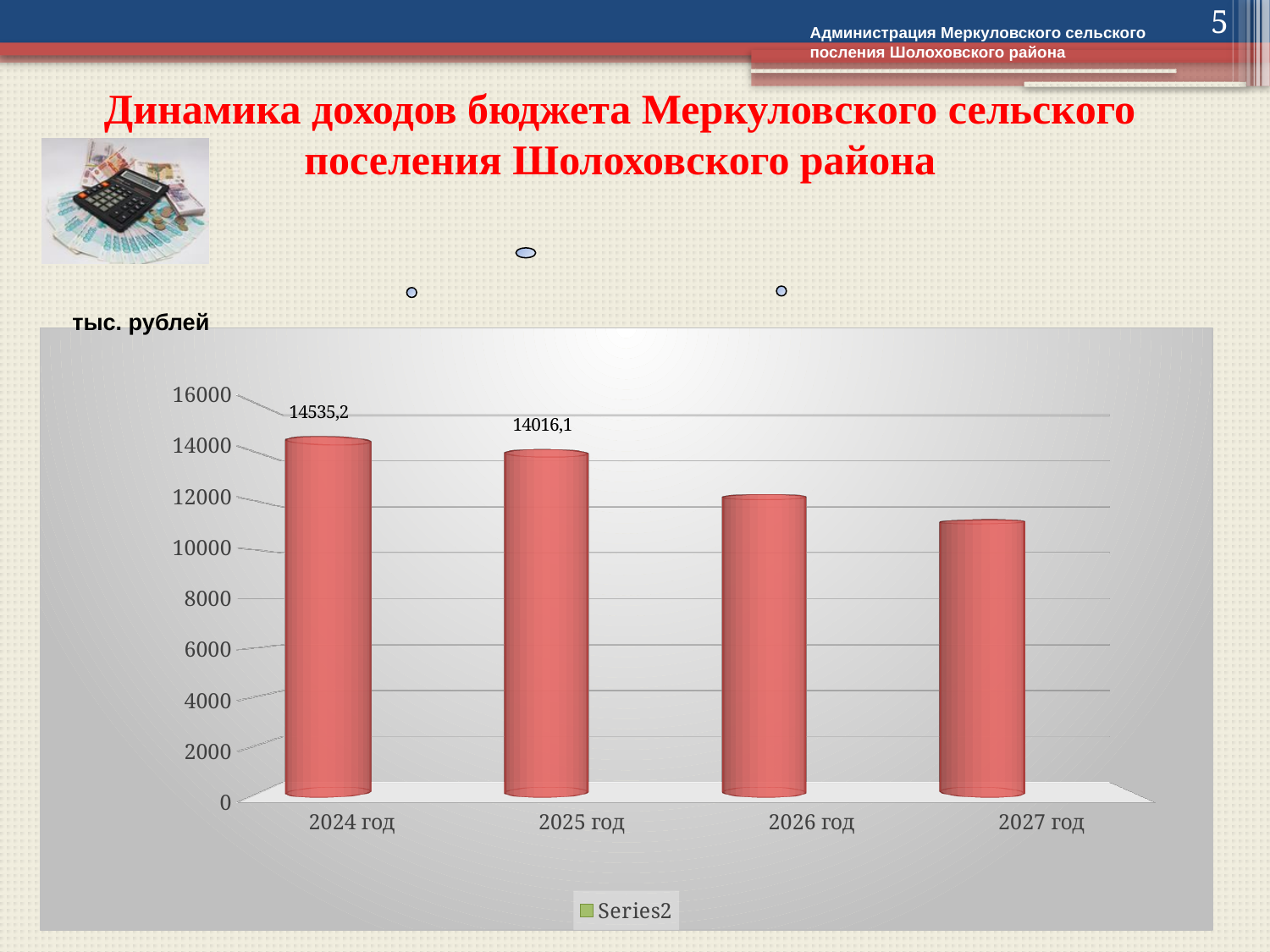
How many years are shown on the x axis? 4 What is the value for 2024 год? 14535,2 Is the value for 2026 год greater or less than 10000? greater What kind of chart is shown on the slide? bar chart Which year has the lowest value? 2027 год Is the value for 2027 год greater or less than 12000? less What is the difference between the values for 2024 год and 2025 год? 519,1 Which year has the highest value? 2024 год Which is larger, the value for 2025 год or the value for 2027 год? 2025 год Do the values rise or fall from 2024 год to 2027 год? fall What is the value for 2025 год? 14016,1 What unit is indicated above the chart? тыс. рублей